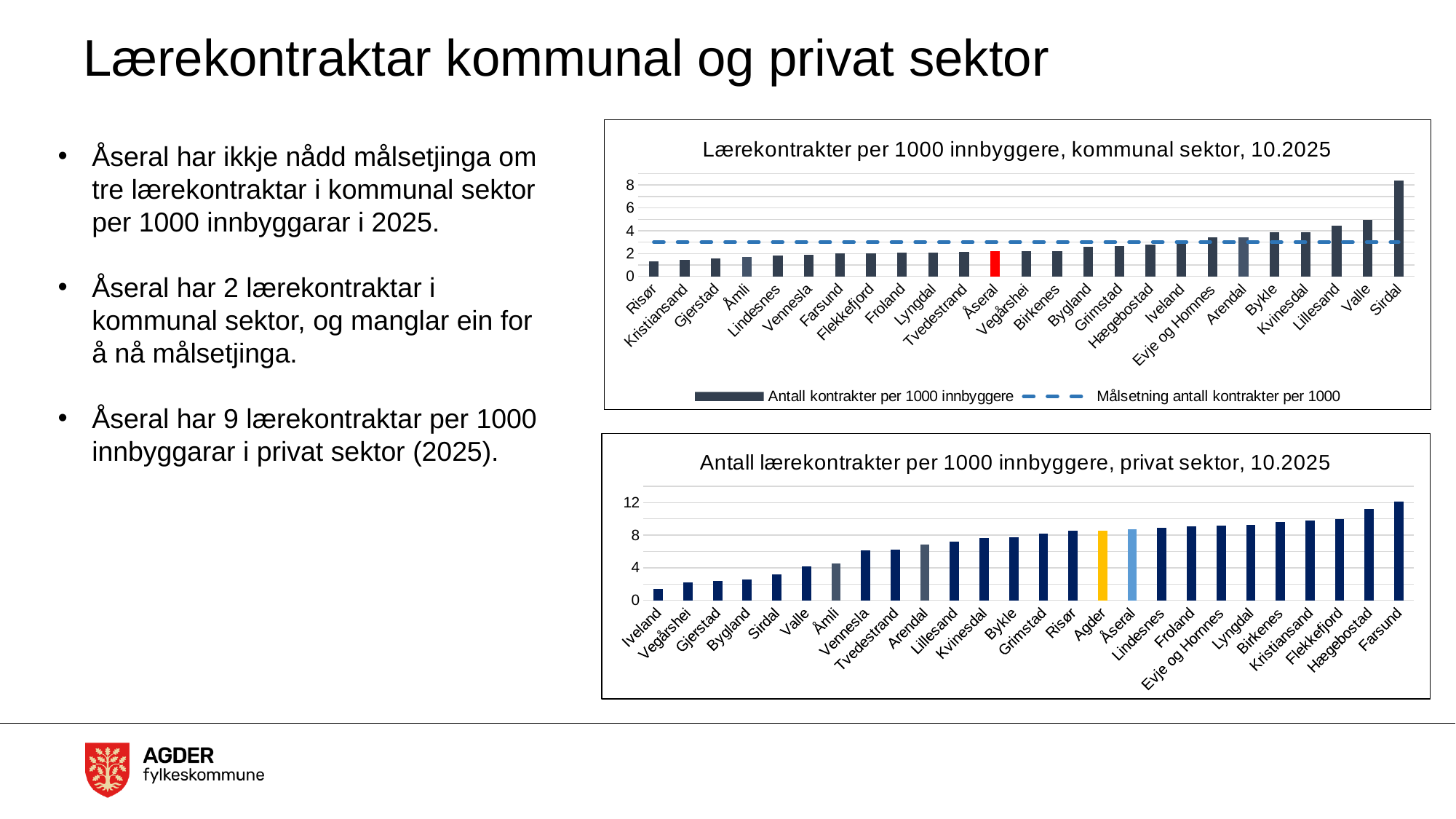
In the top chart (kommunal sektor), is the value for Risør greater or less than 2? less In the bottom chart (privat sektor), do the values rise or fall from left to right along the x axis? rise In the bottom chart (privat sektor), is the value for Farsund greater or less than 8? greater What kind of chart is the top chart, 'Lærekontrakter per 1000 innbyggere, kommunal sektor, 10.2025'? Combination bar and line chart (bars with a dashed target line) In the top chart (kommunal sektor), which municipality has the highest number of contracts per 1000 inhabitants? Sirdal In the top chart (kommunal sektor), which bar is coloured red? Åseral In the bottom chart (privat sektor), which municipality has the lowest value? Iveland In the bottom chart (privat sektor), which municipality has the highest value? Farsund In the bottom chart (privat sektor), which is larger, the value for Vennesla or the value for Gjerstad? Vennesla In the top chart (kommunal sektor), is the value for Sirdal greater or less than 6? greater In the top chart (kommunal sektor), which municipality has the lowest number of contracts per 1000 inhabitants? Risør How many series does the legend of the top chart (kommunal sektor) list? 2